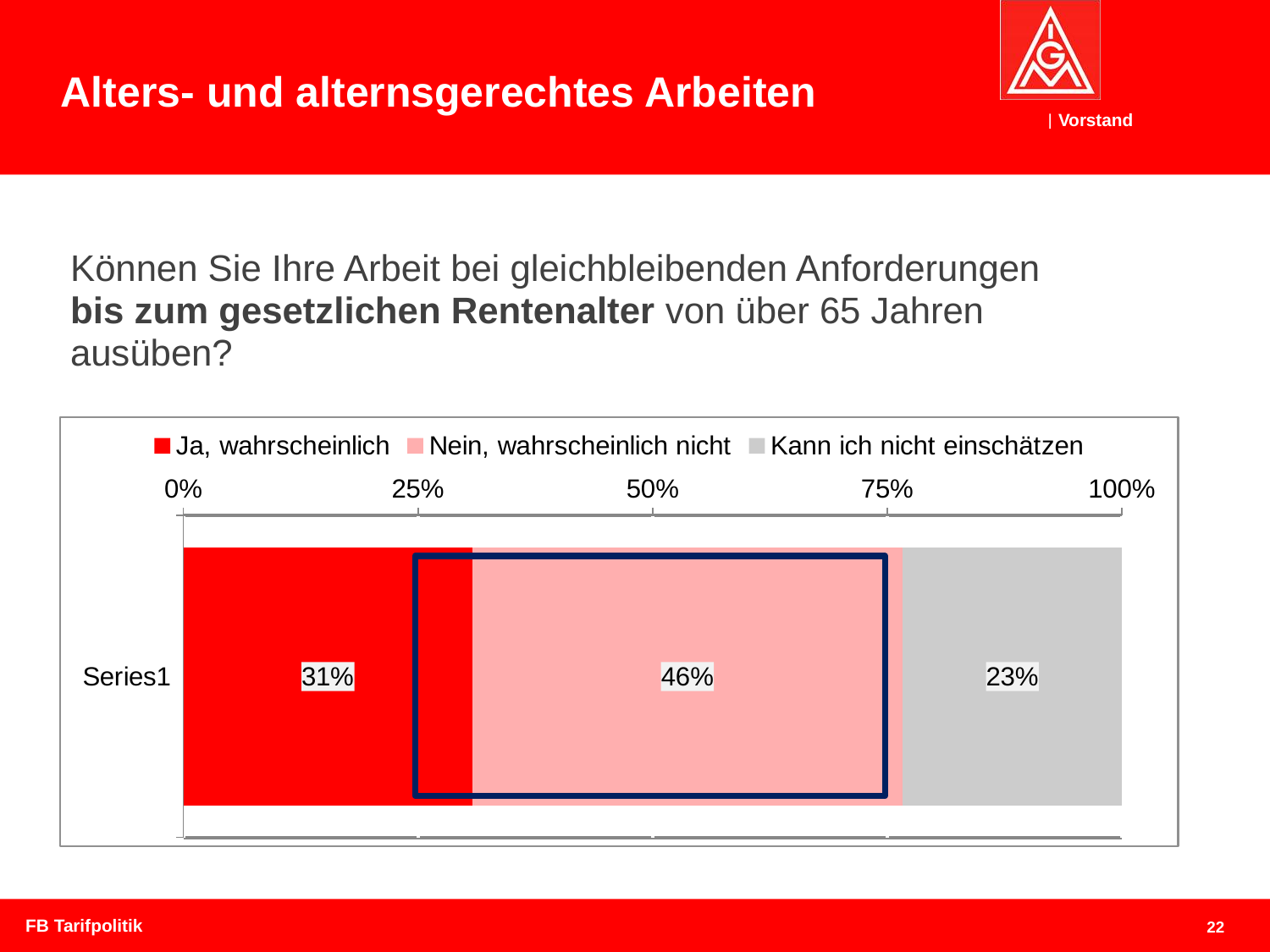
What is the total of the stacked bar? 100% Is the value for "Nein, wahrscheinlich nicht" greater or less than 25%? greater What percentage of respondents answered "Kann ich nicht einschätzen"? 23% How many series does the legend list? 3 Which is larger: the share for "Ja, wahrscheinlich" or the share for "Kann ich nicht einschätzen"? Ja, wahrscheinlich What percentage of respondents answered "Nein, wahrscheinlich nicht"? 46% What colour represents "Kann ich nicht einschätzen" in the chart? Grey What kind of chart is shown on the slide? Stacked bar chart What is the difference between the "Nein, wahrscheinlich nicht" share and the "Ja, wahrscheinlich" share? 15% Which response category has the largest share? Nein, wahrscheinlich nicht Which response category has the smallest share? Kann ich nicht einschätzen What percentage of respondents answered "Ja, wahrscheinlich"? 31%